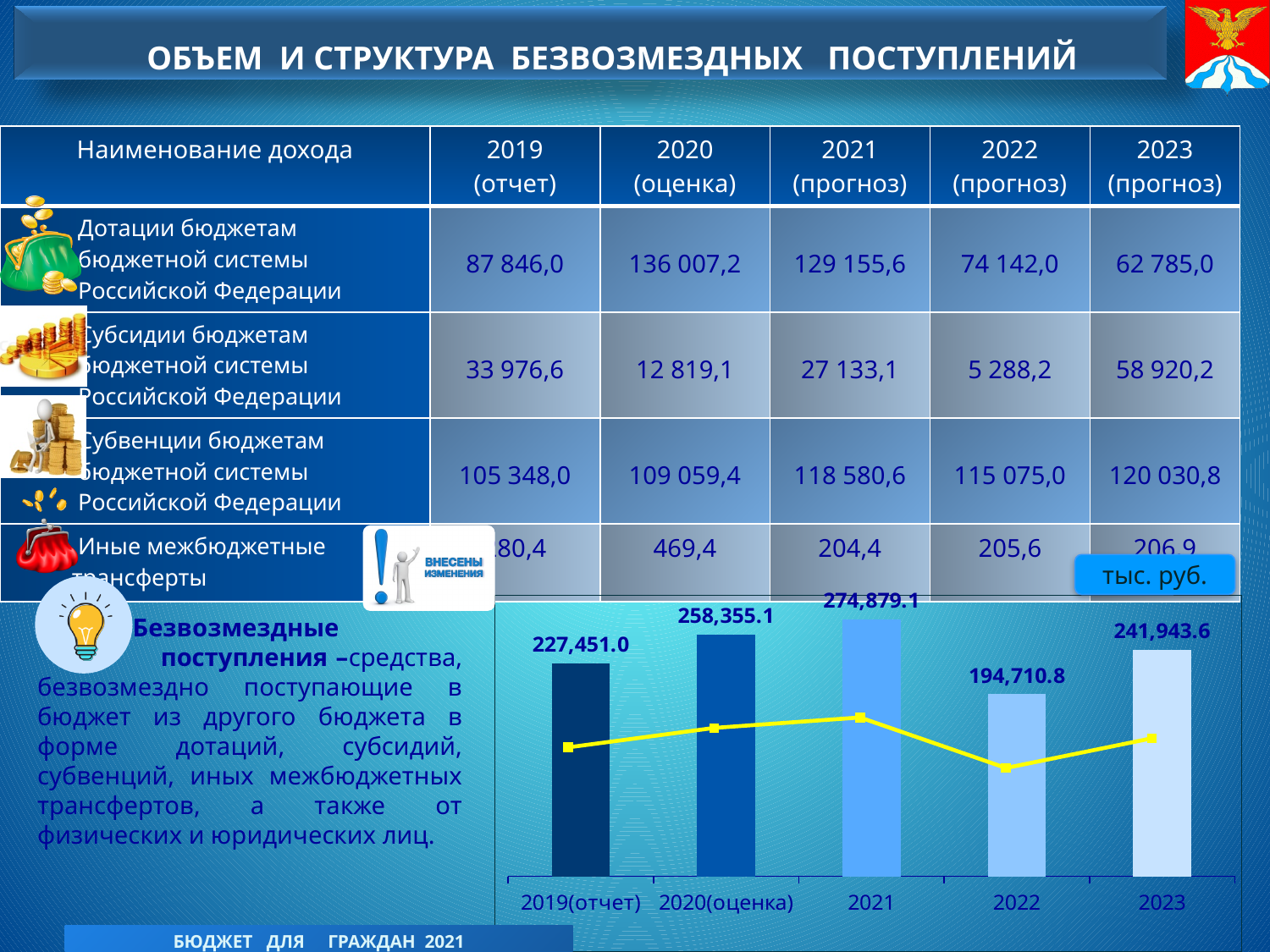
Which year has the lowest bar in the chart? 2022 What is the value shown for 2022 in the bar chart? 194,710.8 What is the difference between the values for 2020(оценка) and 2019(отчет)? 30,904.1 Which year has the highest bar in the chart? 2021 What kind of chart is shown at the bottom of the slide? bar chart What is the value shown for 2019(отчет) in the bar chart? 227,451.0 What is the value shown for 2020(оценка) in the bar chart? 258,355.1 How many years (categories) are shown on the x axis of the chart? 5 Which is larger, the value for 2023 or the value for 2019(отчет)? 2023 What is the value shown for 2023 in the bar chart? 241,943.6 What is the difference between the values for 2021 and 2022? 80,168.3 What is the value shown for 2021 in the bar chart? 274,879.1